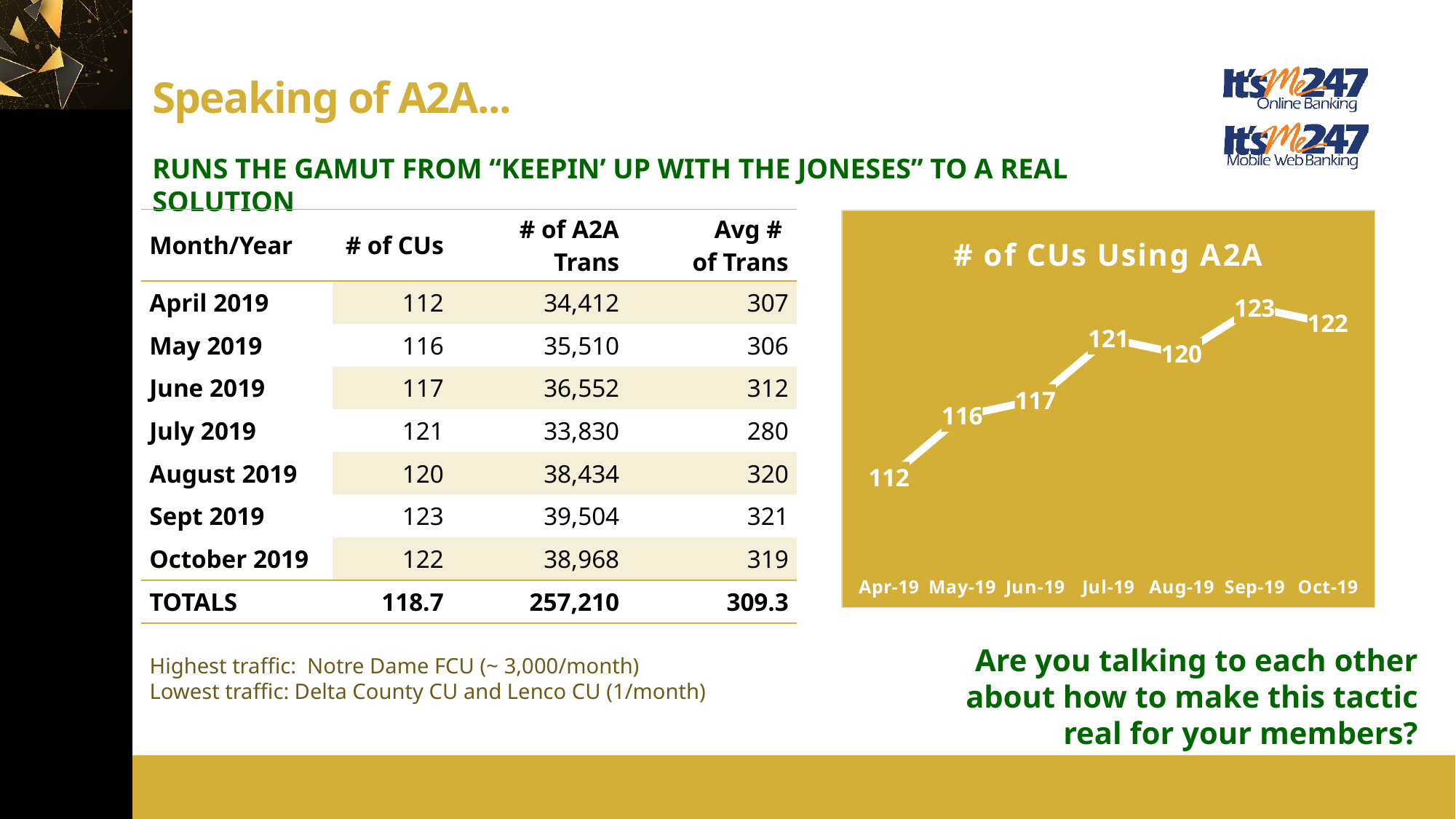
What is the value for Oct-19 in the chart? 122 What is the difference between the values for Sep-19 and Apr-19? 11 Does the number of CUs using A2A generally rise or fall from Apr-19 to Oct-19? rise What is the value for Jul-19 in the chart? 121 What is the difference between the values for Jun-19 and May-19? 1 What is the value for Apr-19 in the chart? 112 How many data points are plotted in the chart? 7 Which month has the highest value in the chart? Sep-19 What kind of chart is shown on the slide? line chart What is the title of the chart? # of CUs Using A2A Which month has the lowest value in the chart? Apr-19 Which is larger, the value for Jul-19 or the value for Aug-19? Jul-19